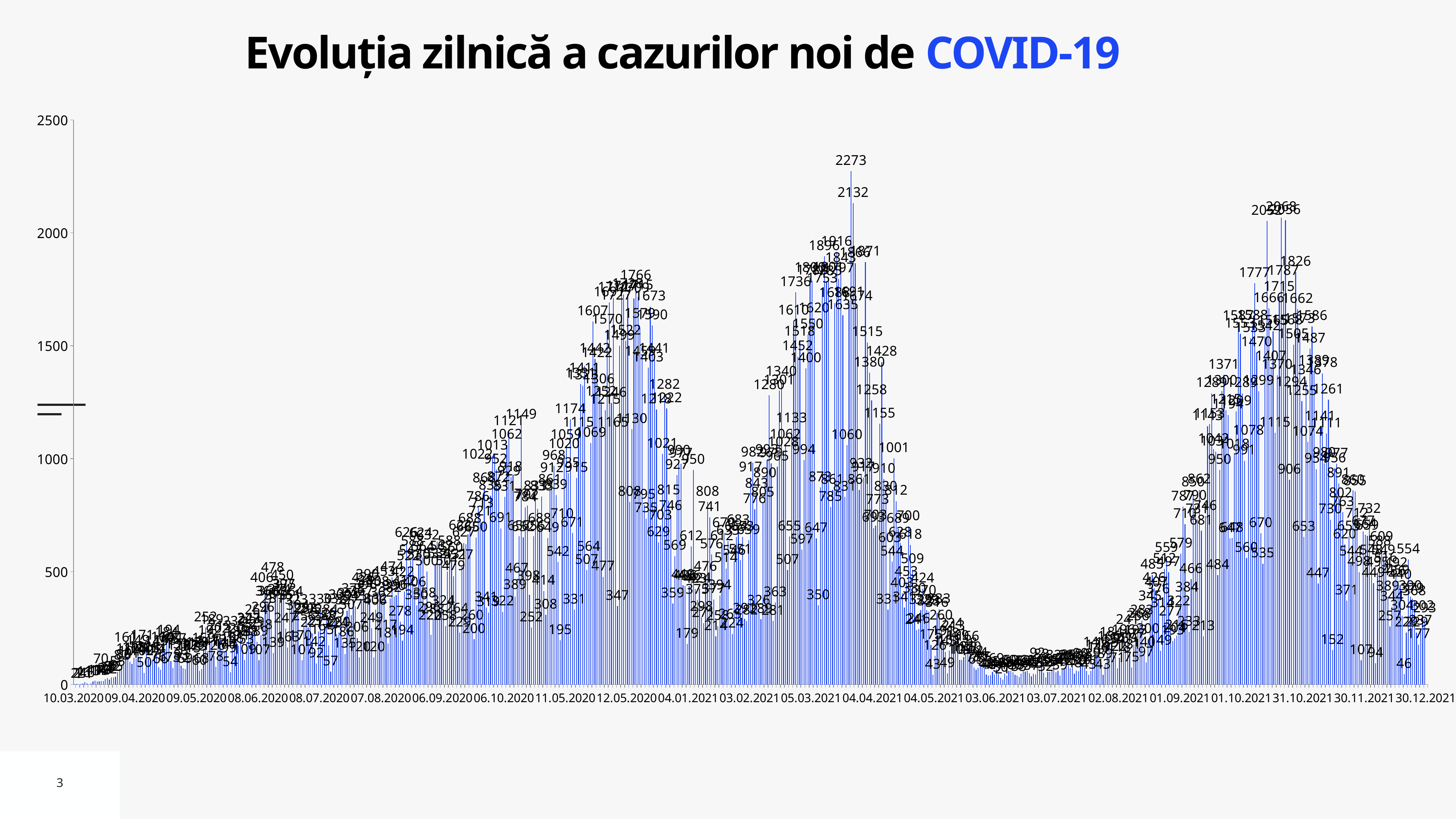
What kind of chart is shown on the slide? bar chart What is the highest daily value labelled on the chart? 2273 What is the highest value shown on the vertical axis? 2500 What is the title of the chart? Evoluția zilnică a cazurilor noi de COVID-19 Do the values rise or fall between 03.07.2021 and 01.10.2021? rise What is the second-highest value labelled near the tallest peak of the chart? 2132 Do the values rise or fall between 04.04.2021 and 03.06.2021? fall Are the daily values around 03.07.2021 greater or less than 500? less Is the highest value on the chart greater or less than 2500? less Is the highest value on the chart greater or less than 2000? greater What is the first date label on the horizontal axis? 10.03.2020 What is the last date label on the horizontal axis? 30.12.2021